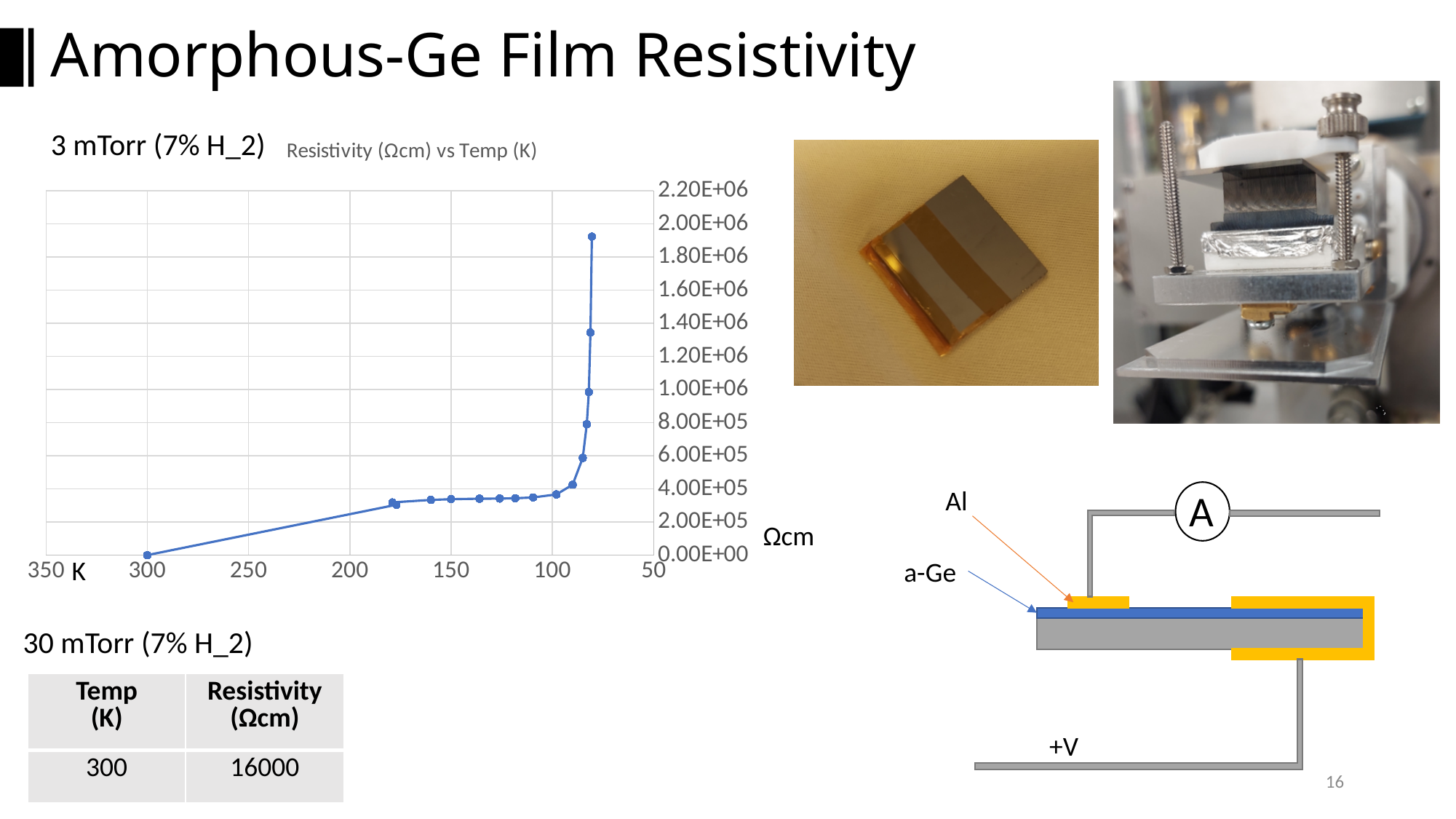
What is the title of the chart? Resistivity (Ωcm) vs Temp (K) Which has the larger plotted resistivity, the point at 300 K or the point at 150 K? 150 K What deposition condition is labelled above the chart? 3 mTorr (7% H_2) Is the resistivity plotted at 150 K greater or less than 4.00E+05? less Moving from left to right along the temperature axis (from 350 K toward 50 K), does the plotted resistivity rise or fall? rise Is the resistivity plotted at 150 K greater or less than 2.00E+05? greater What kind of chart is shown on the slide? line chart Is the resistivity plotted at 300 K greater or less than 2.00E+05? less At which end of the temperature axis does the plotted resistivity reach its maximum, the high-temperature end (300 K) or the low-temperature end (near 80 K)? low-temperature end (near 80 K) What is the highest tick value shown on the chart's vertical axis? 2.20E+06